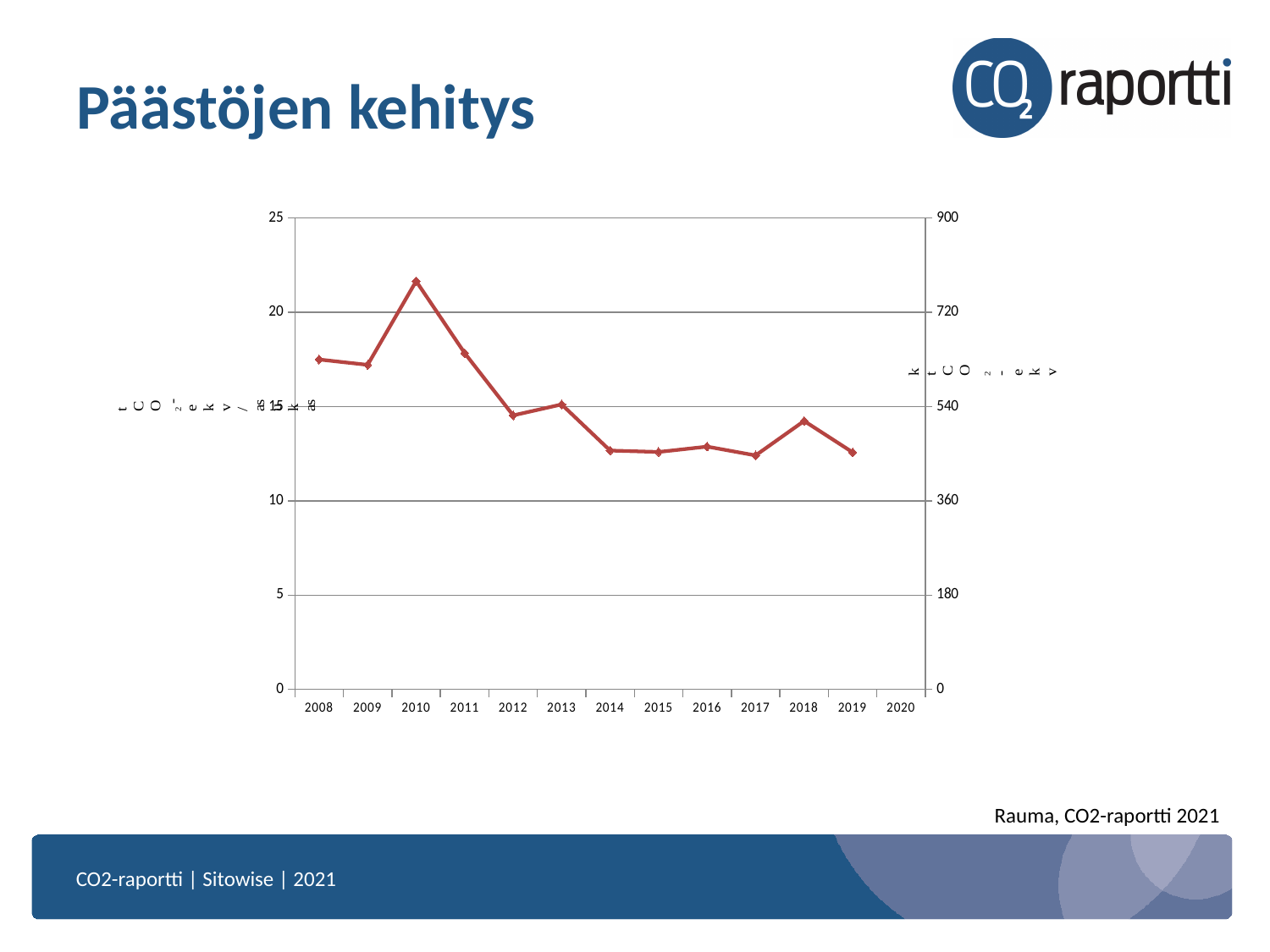
In which year does the line reach its highest value? 2010 What kind of chart is shown on the slide? line chart Is the value for 2014 greater or less than 15 on the left axis? less How many data points are plotted on the line? 12 Which year has the larger value, 2010 or 2012? 2010 Is the value for 2008 greater or less than 15 on the left axis? greater Is the value for 2011 greater or less than 15 on the left axis? greater What is the title of the chart on the slide? Päästöjen kehitys Overall, do the values rise or fall from 2008 to 2019? fall Which year has the larger value, 2017 or 2018? 2018